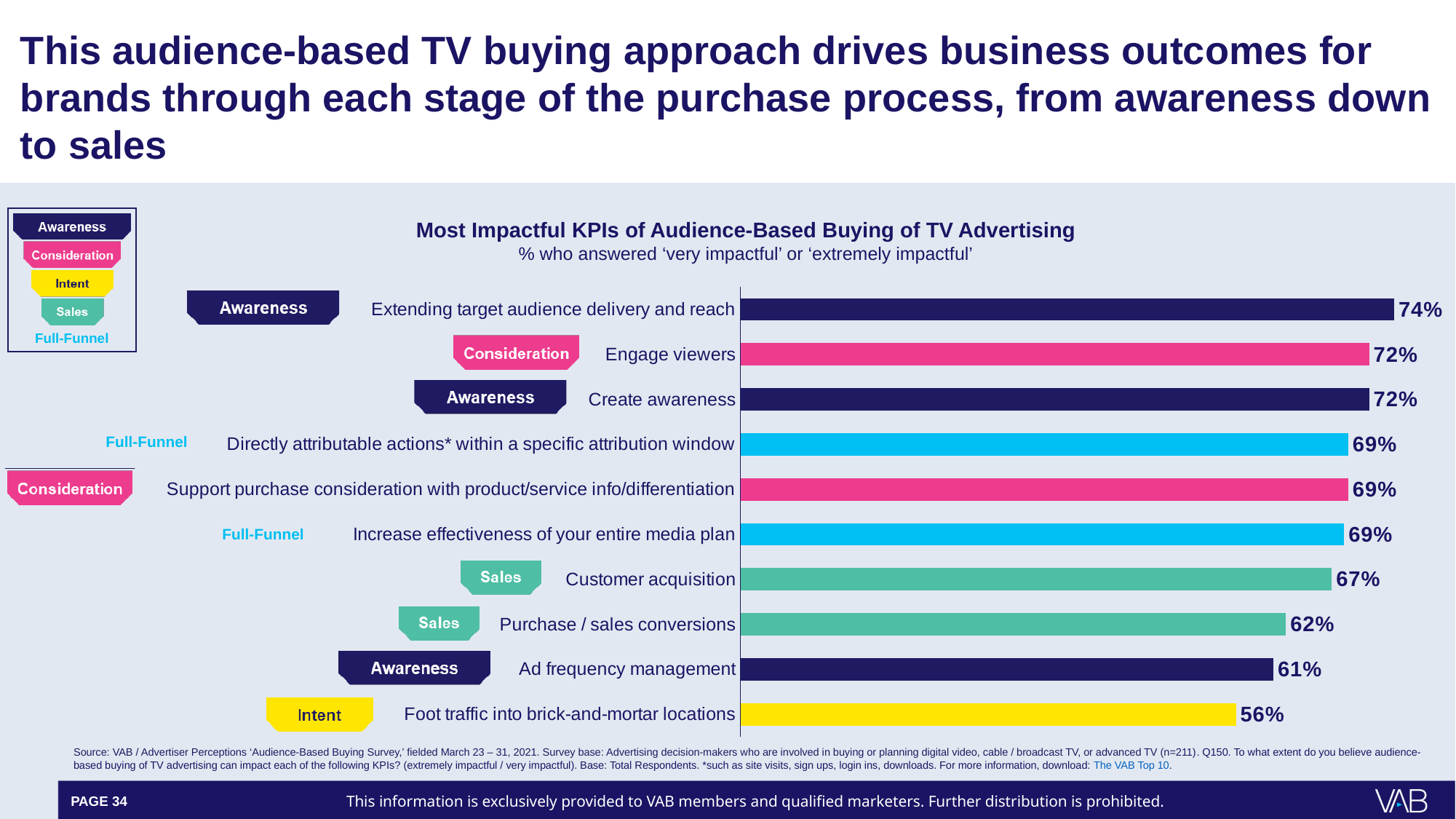
What is the title of the chart? Most Impactful KPIs of Audience-Based Buying of TV Advertising Which funnel stage label is attached to the 'Engage viewers' bar? Consideration Which has a higher value: 'Ad frequency management' or 'Customer acquisition'? Customer acquisition What is the value shown for 'Purchase / sales conversions'? 62% What is the value shown for 'Foot traffic into brick-and-mortar locations'? 56% What is the value shown for 'Customer acquisition'? 67% Which KPI has the highest percentage in the chart? Extending target audience delivery and reach How many KPIs are plotted in the chart? 10 Which KPI has the lowest percentage in the chart? Foot traffic into brick-and-mortar locations What type of chart is shown on the slide? Bar chart What is the difference between the values for 'Extending target audience delivery and reach' and 'Foot traffic into brick-and-mortar locations'? 18% What percentage of respondents rated 'Extending target audience delivery and reach' as very or extremely impactful? 74%